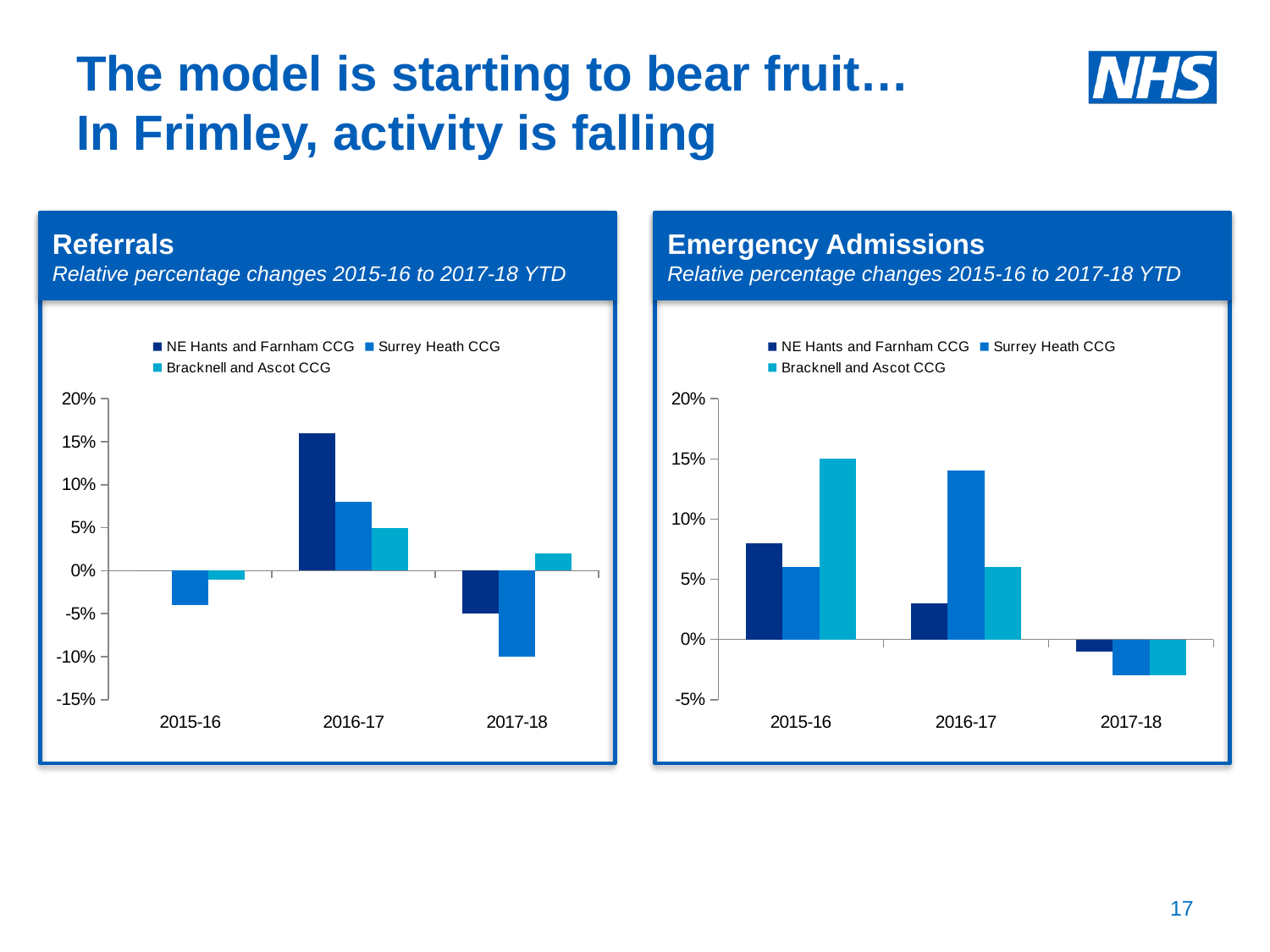
In the Emergency Admissions chart, which CCG has the highest value in 2015-16? Bracknell and Ascot CCG In the Referrals chart, which CCG has the lowest value in 2017-18? Surrey Heath CCG In the Emergency Admissions chart, is the value for NE Hants and Farnham CCG in 2016-17 greater or less than 5%? less How many series does the legend of the Emergency Admissions chart list? 3 In the Referrals chart, is the value for NE Hants and Farnham CCG in 2016-17 greater or less than 15%? greater In the Emergency Admissions chart, is the value for Surrey Heath CCG in 2016-17 greater or less than 10%? greater In the Referrals chart, which CCG has the highest value in 2016-17? NE Hants and Farnham CCG What is the subtitle shown under the Emergency Admissions chart title? Relative percentage changes 2015-16 to 2017-18 YTD In the Emergency Admissions chart, which CCG has the highest value in 2016-17? Surrey Heath CCG How many year categories are shown on the x axis of the Referrals chart? 3 In the Referrals chart, what is the value for Surrey Heath CCG in 2017-18? -10% What kind of chart is the Referrals chart? bar chart